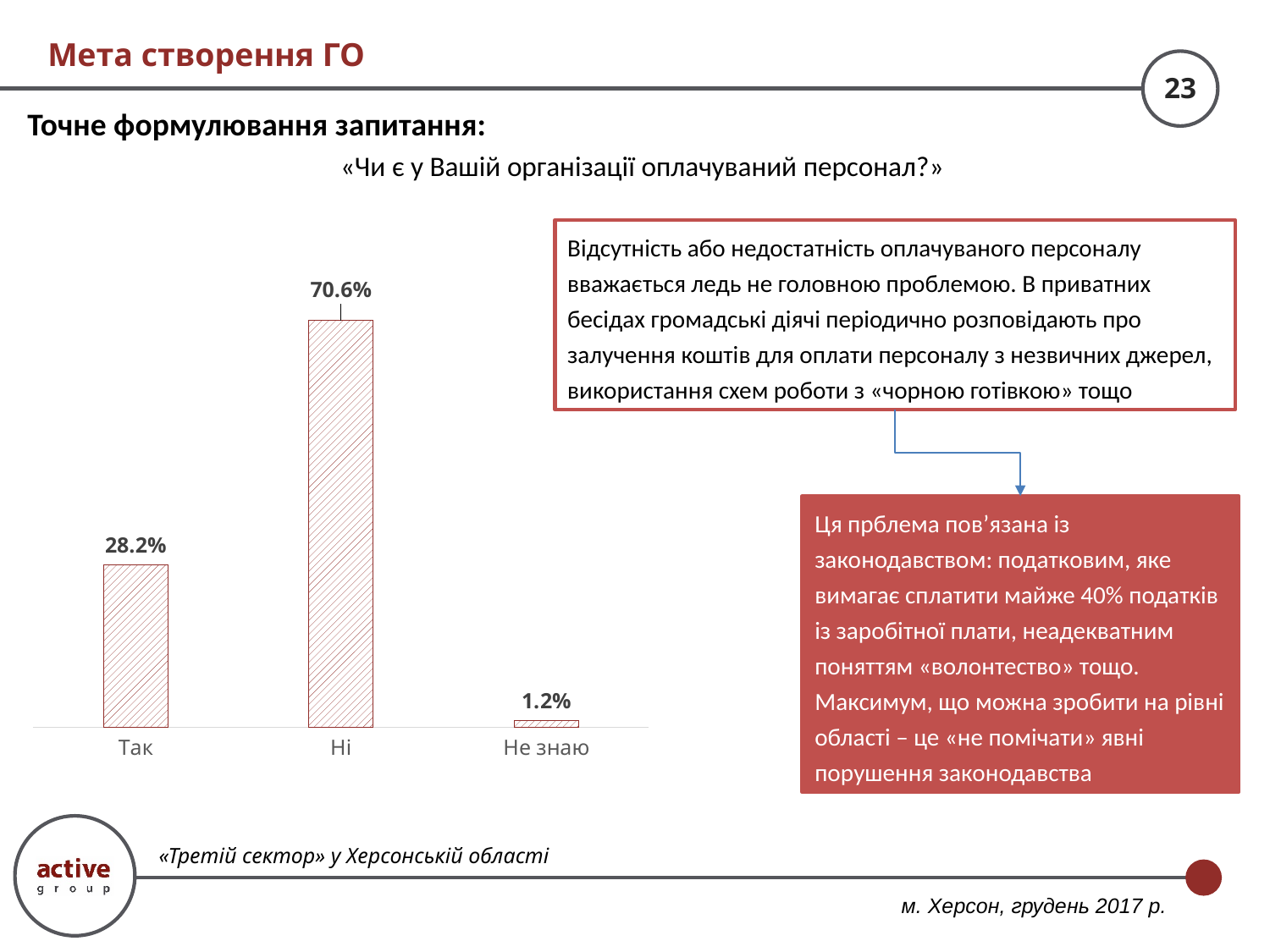
Which category has the highest value? Ні What is the difference between the values for "Ні" and "Так"? 42.4% Which category has the lowest value? Не знаю What is the value for "Так"? 28.2% Which is larger, the value for "Так" or the value for "Ні"? Ні What kind of chart is shown on the slide? bar chart What fill pattern do the bars use? red diagonal hatching What is the value for "Не знаю"? 1.2% What is the difference between the values for "Так" and "Не знаю"? 27.0% What survey question does the chart present? «Чи є у Вашій організації оплачуваний персонал?» How many categories are shown in the chart? 3 What is the value for "Ні"? 70.6%